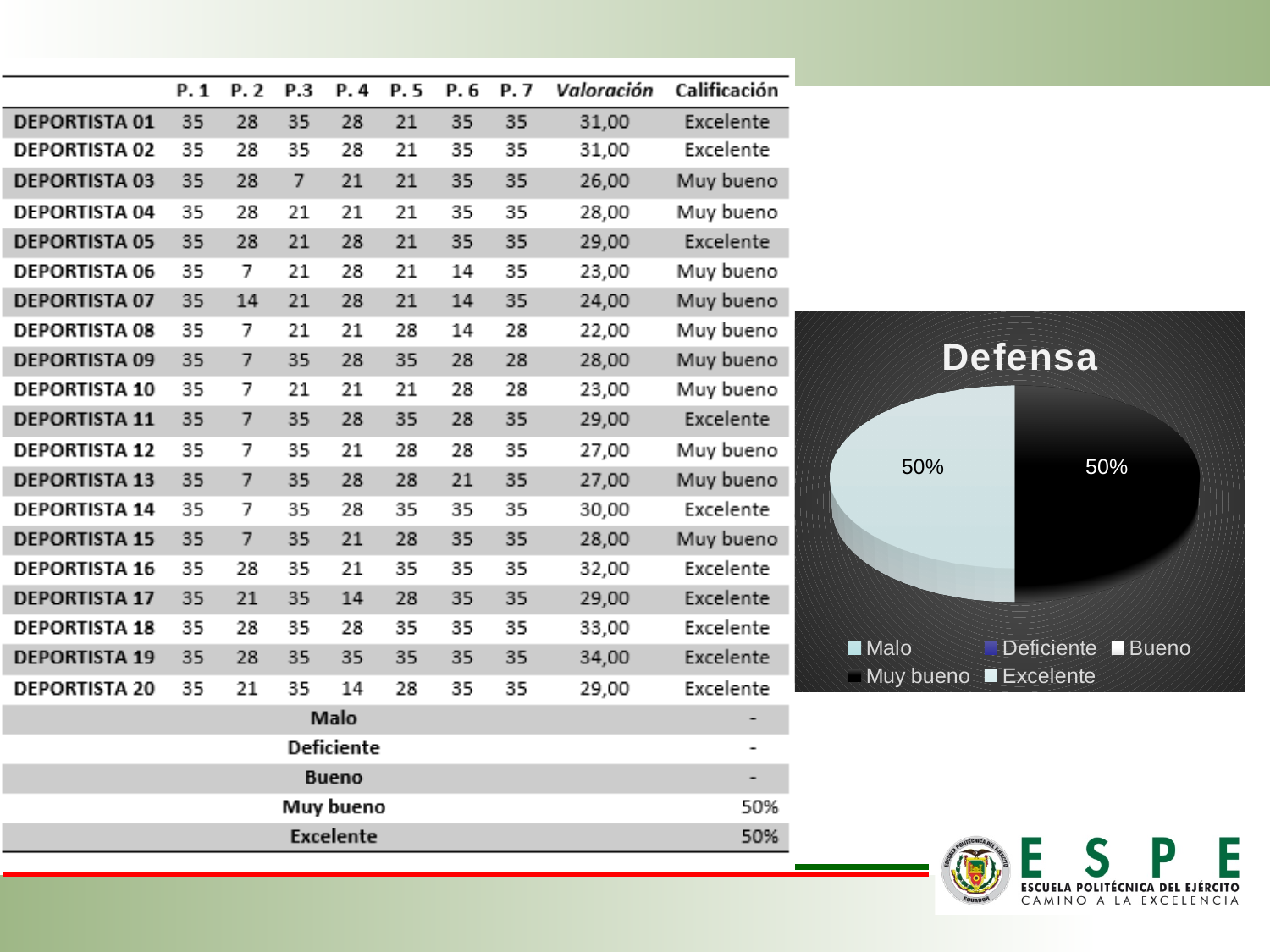
What value is labelled on the black slice of the Defensa pie chart? 50% Is the share of the Excelente slice in the Defensa pie chart greater or less than 25%? greater What is the total of the two labelled slices in the Defensa pie chart? 100% What kind of chart is shown on the slide? pie chart What value is labelled on the light-coloured slice of the Defensa pie chart? 50% How many slices are visible in the Defensa pie chart? 2 What is the title of the pie chart? Defensa Which legend entry corresponds to the black slice of the Defensa pie chart? Muy bueno What share of the Defensa pie chart does the Excelente slice represent? 50% How many entries does the legend of the Defensa pie chart list? 5 What share of the Defensa pie chart does the Muy bueno slice represent? 50%